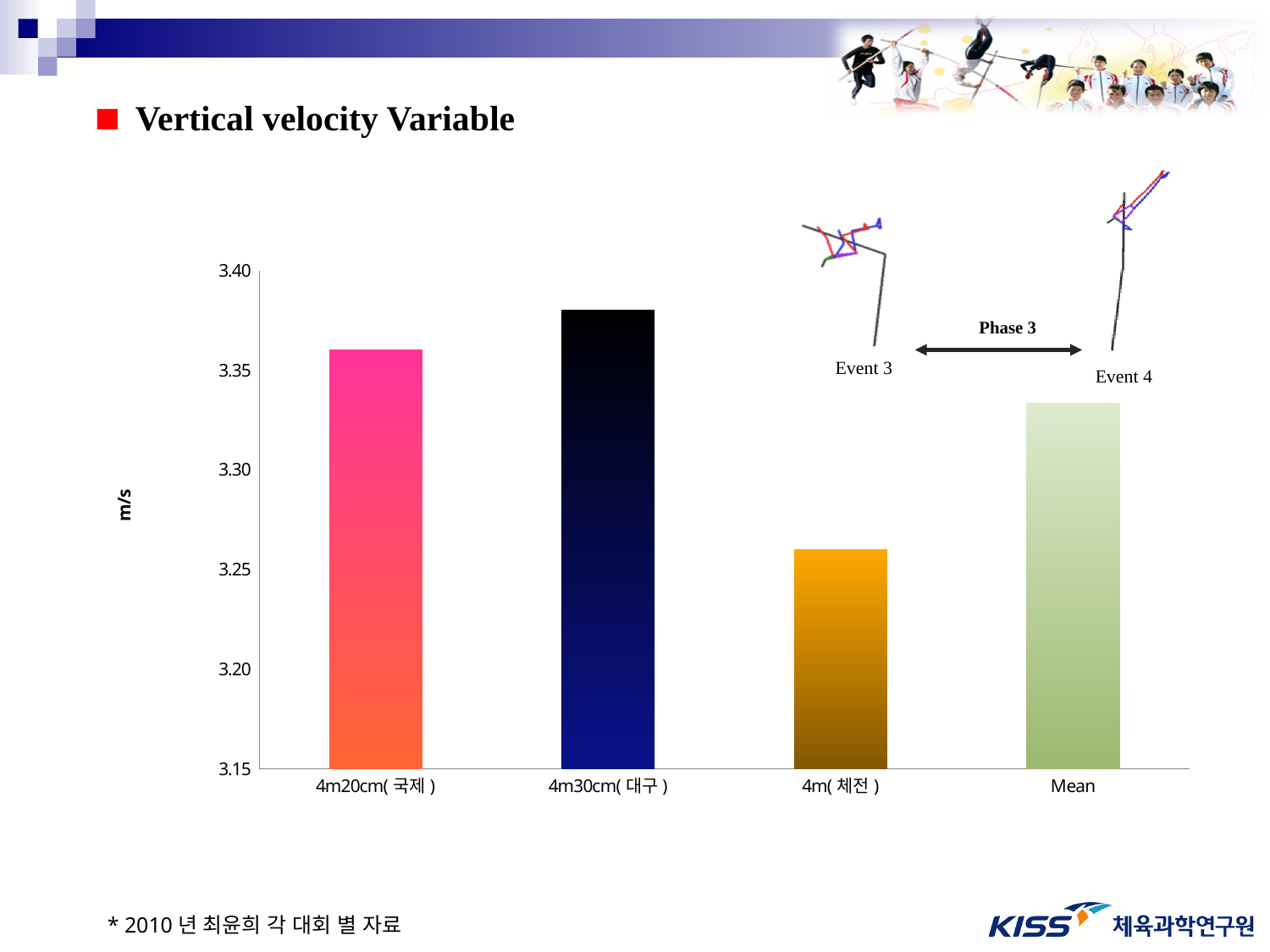
Which is larger, the value for 4m20cm( 국제 ) or the value for 4m( 체전 )? 4m20cm( 국제 ) Which category has the highest vertical velocity? 4m30cm( 대구 ) Is the value for 4m( 체전 ) greater or less than 3.30? less Is the value for 4m20cm( 국제 ) greater or less than 3.35? greater Which category has the lowest vertical velocity? 4m( 체전 ) Is the value for 4m30cm( 대구 ) greater or less than 3.35? greater What kind of chart is shown on the slide? bar chart How many categories are shown on the x axis of the chart? 4 Which is larger, the value for Mean or the value for 4m30cm( 대구 )? 4m30cm( 대구 ) What unit is shown on the y axis of the chart? m/s What is the title of the slide above the chart? Vertical velocity Variable